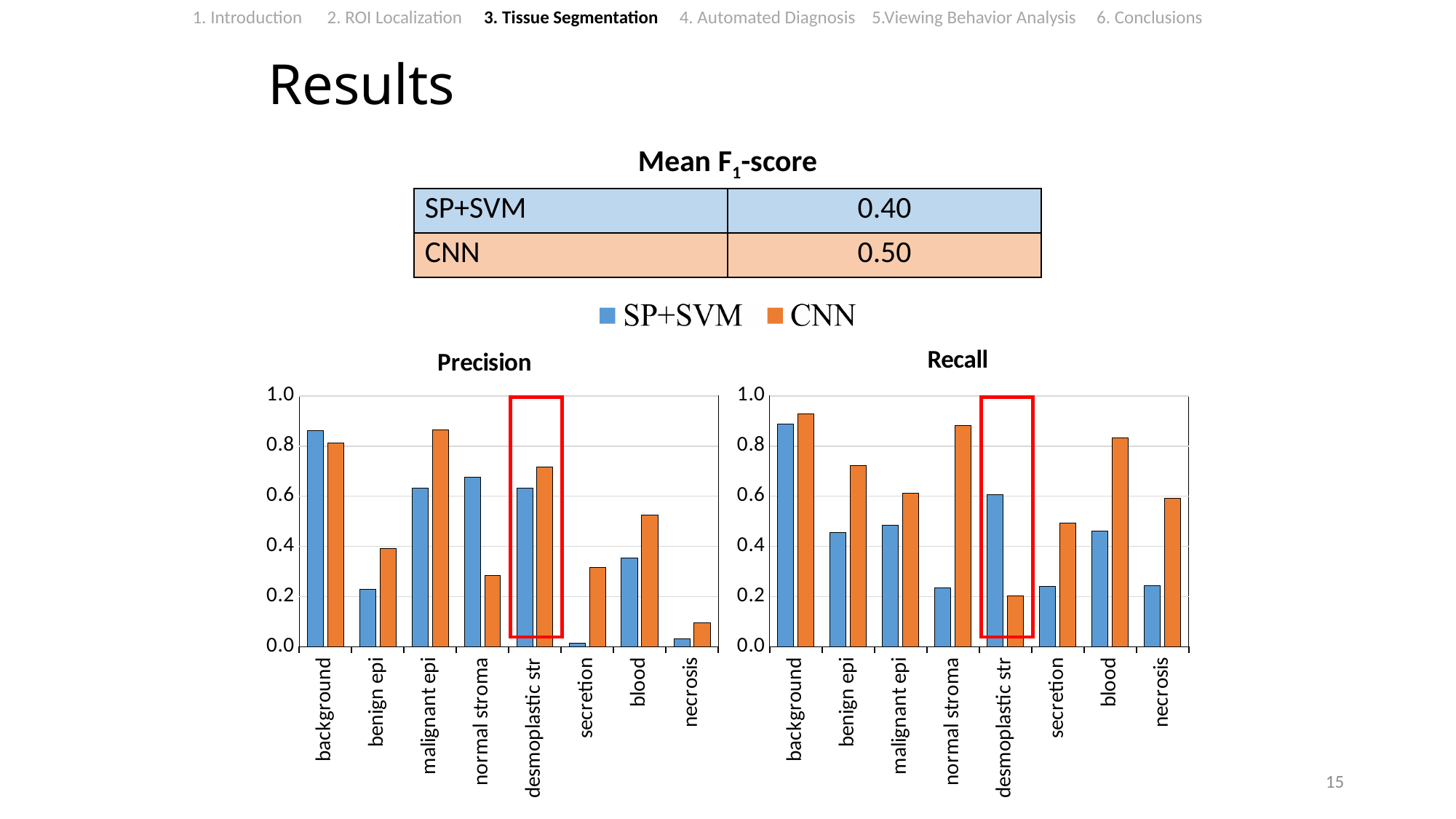
How many series does the legend list for the charts? 2 In the Recall chart, which is larger for desmoplastic str: SP+SVM or CNN? SP+SVM In the Precision chart, is the CNN value for normal stroma greater or less than 0.4? less In the Recall chart, is the CNN value for blood greater or less than 0.8? greater In the Precision chart, which category has the highest SP+SVM value? background In the Recall chart, which category has the lowest CNN value? desmoplastic str What kind of chart is the Precision chart? bar chart How many categories are shown on the x axis of the Recall chart? 8 In the Precision chart, which category has the lowest CNN value? necrosis Which colour represents CNN in the legend? orange In the Precision chart, which is larger for malignant epi: SP+SVM or CNN? CNN In the Precision chart, which category has the lowest SP+SVM value? secretion